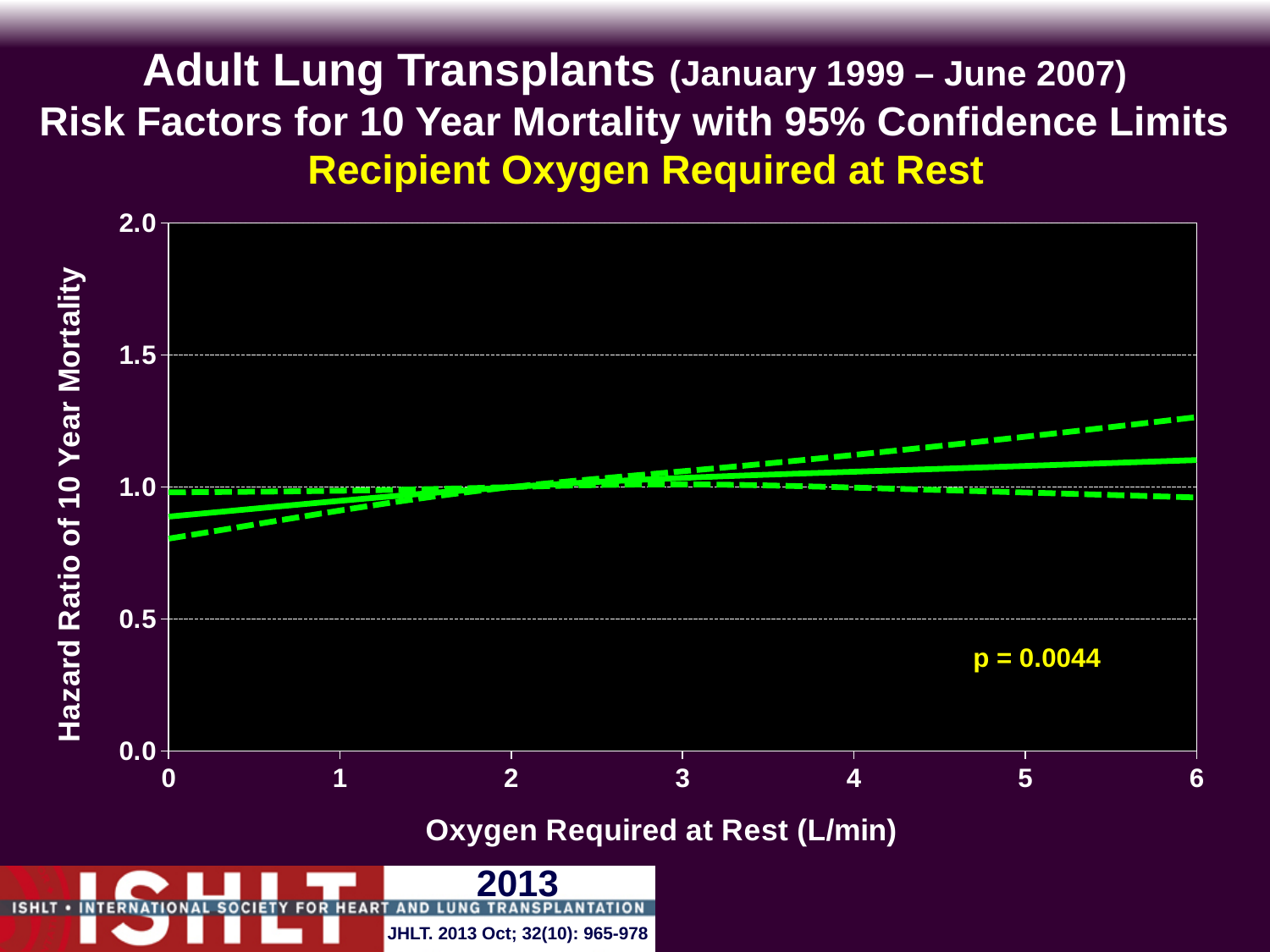
What is the p-value printed on the chart? p = 0.0044 Does the solid hazard ratio line rise or fall as oxygen required at rest increases from 0 to 6 L/min? rise What is the label of the x axis? Oxygen Required at Rest (L/min) What is the maximum value shown on the y axis? 2.0 Is the hazard ratio shown by the solid line at 0 L/min greater or less than 1.0? less Is the lower dashed confidence limit at 0 L/min greater or less than 0.5? greater Does the upper dashed confidence limit rise or fall along the x axis? rise What kind of chart is shown on the slide? line chart Is the hazard ratio shown by the solid line at 6 L/min greater or less than 1.0? greater How many lines are plotted on the chart? 3 What is the maximum value shown on the x axis? 6